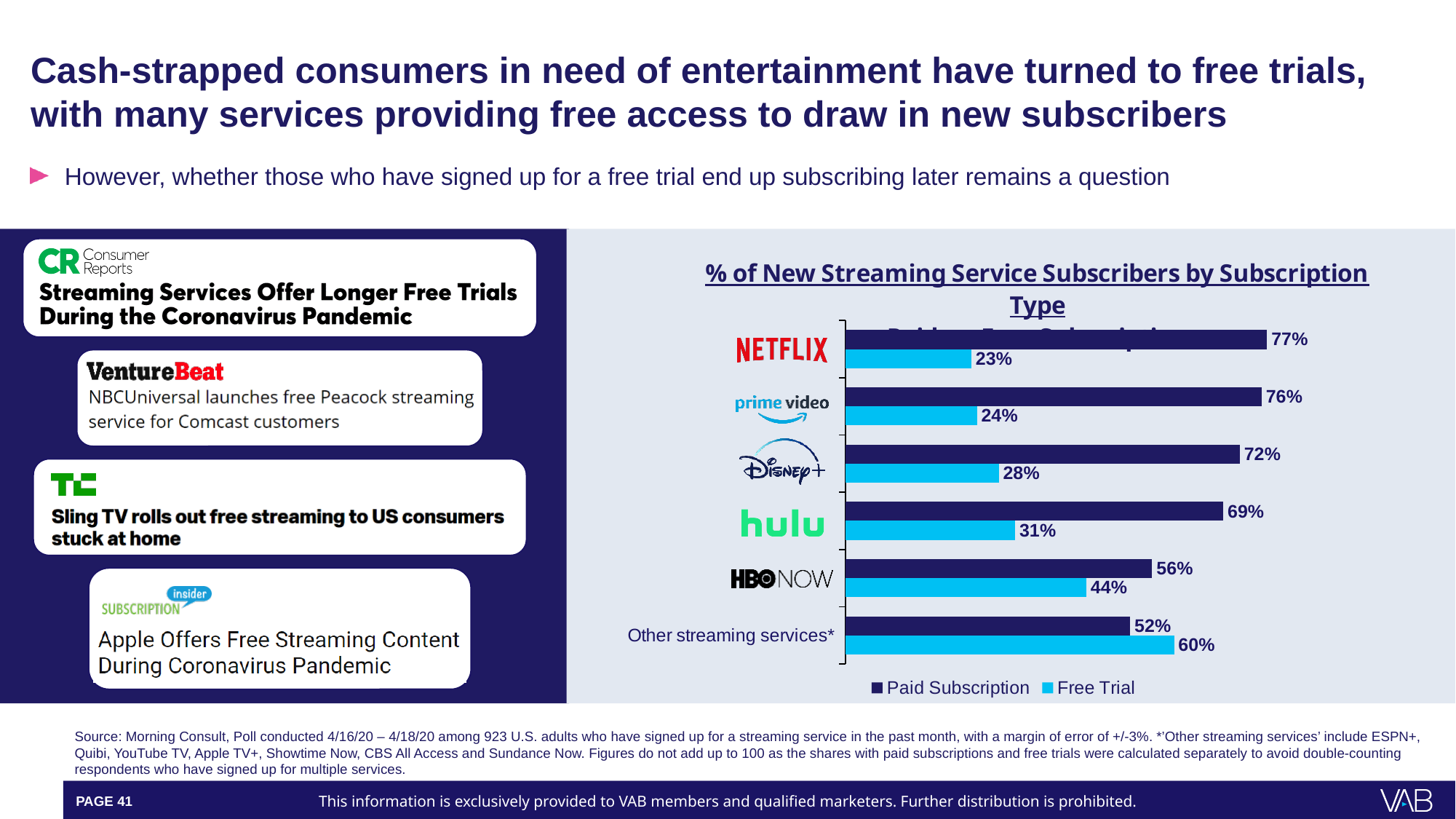
What is the Free Trial value for Other streaming services*? 60% How many streaming service categories are shown in the chart? 6 Which is larger for Disney+: Paid Subscription or Free Trial? Paid Subscription What type of chart is shown on the slide? Bar chart How many series does the legend list? 2 Which service has the highest Paid Subscription percentage? Netflix Which category has the lowest Paid Subscription percentage? Other streaming services* What is the difference between the Paid Subscription and Free Trial values for HBO Now? 12% Which service has the lowest Free Trial percentage? Netflix What percentage of new Netflix subscribers have a paid subscription? 77% What is the Free Trial value for Hulu? 31% Which colour represents Free Trial in the chart? Light blue